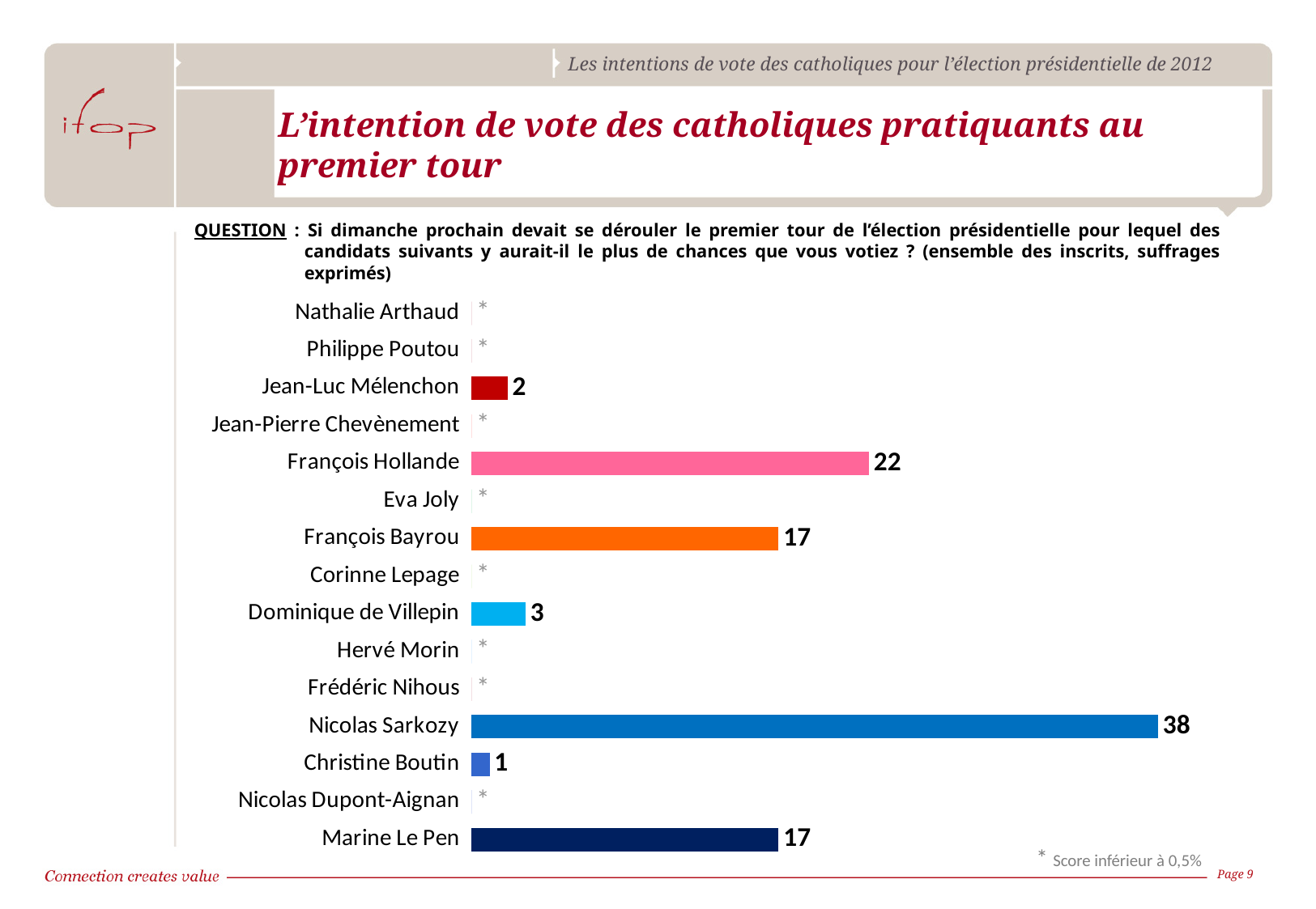
What kind of chart is shown on the slide? Bar chart What is the value for Dominique de Villepin? 3 What is the value for Christine Boutin? 1 How many candidates are listed on the chart? 15 What is the difference between the values for François Hollande and François Bayrou? 5 What is the value for Nicolas Sarkozy? 38 Among the candidates with a plotted bar, which has the lowest value? Christine Boutin What is the value for François Hollande? 22 Which is larger, the value for Jean-Luc Mélenchon or the value for Dominique de Villepin? Dominique de Villepin Which candidate has the highest value? Nicolas Sarkozy According to the footnote, what does the asterisk next to a candidate's name mean? Score inférieur à 0,5% What is the difference between the values for Nicolas Sarkozy and François Hollande? 16